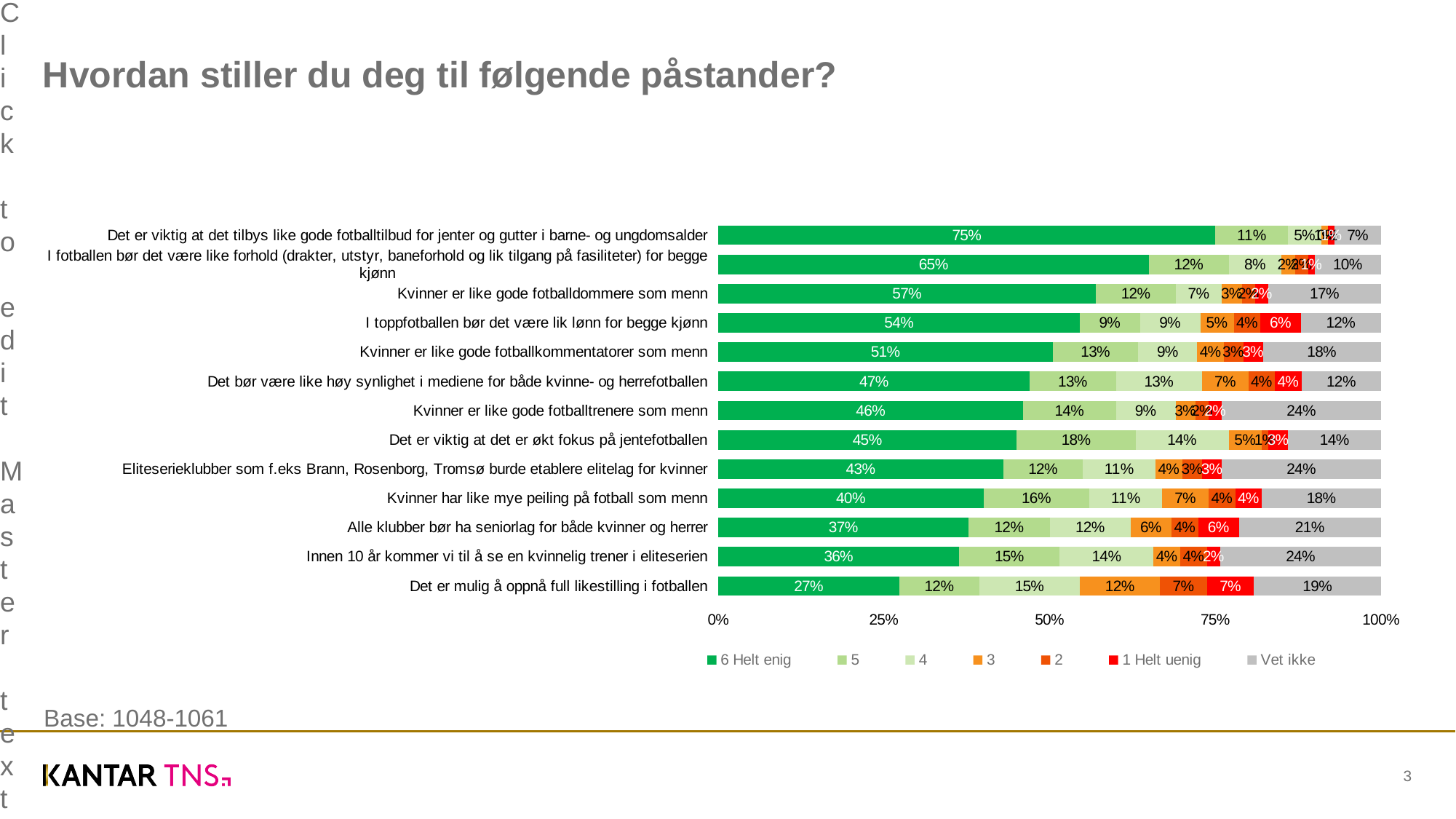
What is the value for series '5' for 'Det er viktig at det er økt fokus på jentefotballen'? 18% What is the difference in '6 Helt enig' share between 'Det er viktig at det tilbys like gode fotballtilbud for jenter og gutter i barne- og ungdomsalder' and 'Det er mulig å oppnå full likestilling i fotballen'? 48 percentage points What is the 'Vet ikke' value for 'Kvinner er like gode fotballtrenere som menn'? 24% What kind of chart is shown on the slide? Stacked bar chart What is the '1 Helt uenig' value for 'Det er mulig å oppnå full likestilling i fotballen'? 7% Which has the larger '6 Helt enig' share: 'I toppfotballen bør det være lik lønn for begge kjønn' or 'Kvinner er like gode fotballkommentatorer som menn'? I toppfotballen bør det være lik lønn for begge kjønn What is the '6 Helt enig' value for 'Det er mulig å oppnå full likestilling i fotballen'? 27% How many series does the legend list? 7 What is the first entry in the chart's legend? 6 Helt enig Which statement has the lowest '6 Helt enig' share? Det er mulig å oppnå full likestilling i fotballen Which statement has the highest '6 Helt enig' share? Det er viktig at det tilbys like gode fotballtilbud for jenter og gutter i barne- og ungdomsalder How many statements (categories) are plotted in the chart? 13